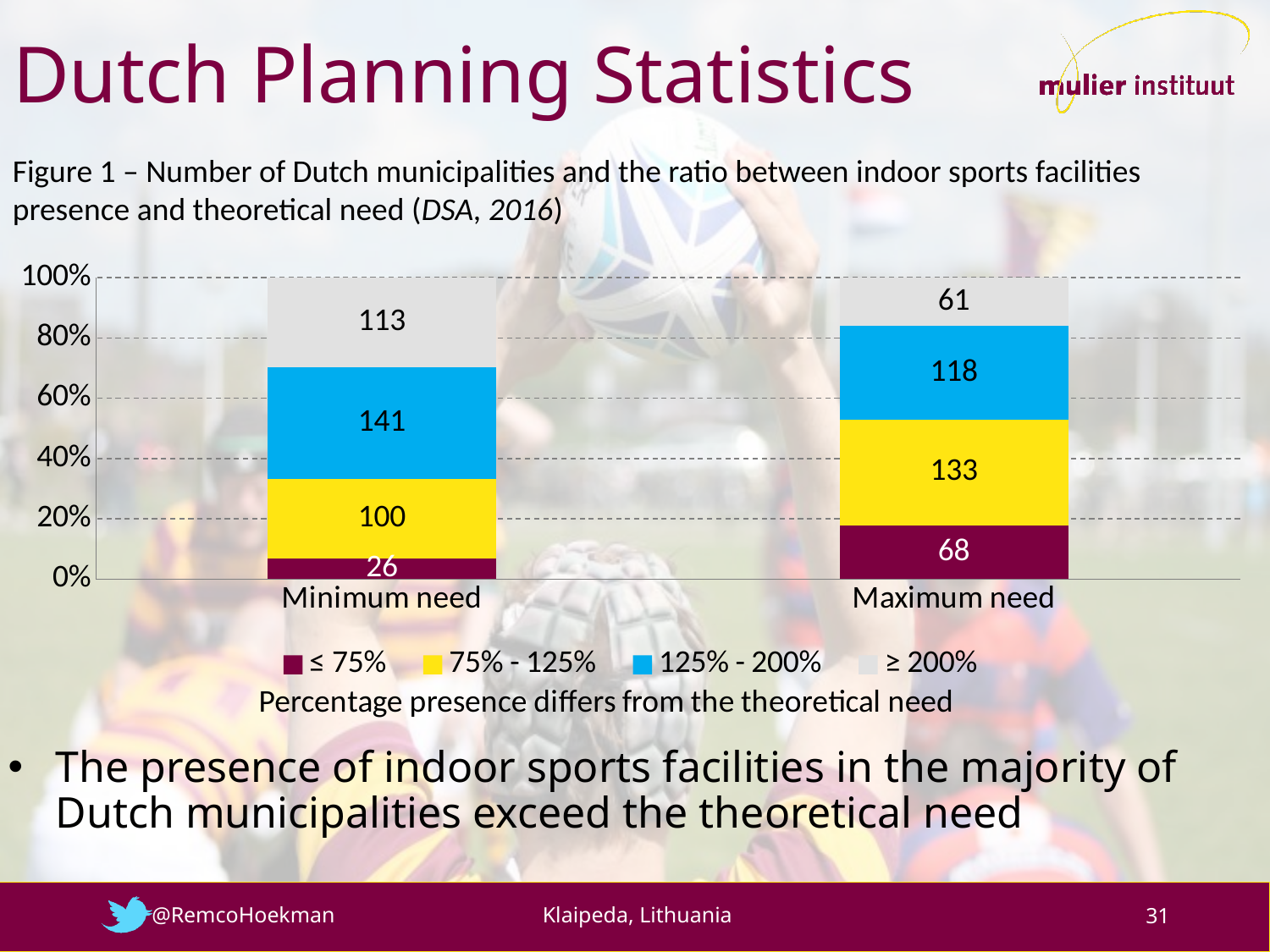
What is the value for the "≤ 75%" series in the Maximum need bar? 68 How many series does the legend list? 4 What is the value for the "75% - 125%" series in the Maximum need bar? 133 What is the total of the Minimum need stacked bar? 380 Which is larger: the "≥ 200%" value for Minimum need or for Maximum need? Minimum need What is the value for the "≥ 200%" series in the Minimum need bar? 113 What kind of chart is shown on the slide? Stacked bar chart What is the value for the "125% - 200%" series in the Minimum need bar? 141 Which series has the smallest value in the Maximum need bar? ≥ 200% What is the difference between the "≤ 75%" values for Maximum need and Minimum need? 42 How many categories are shown on the x axis? 2 Which series has the largest value in the Minimum need bar? 125% - 200%